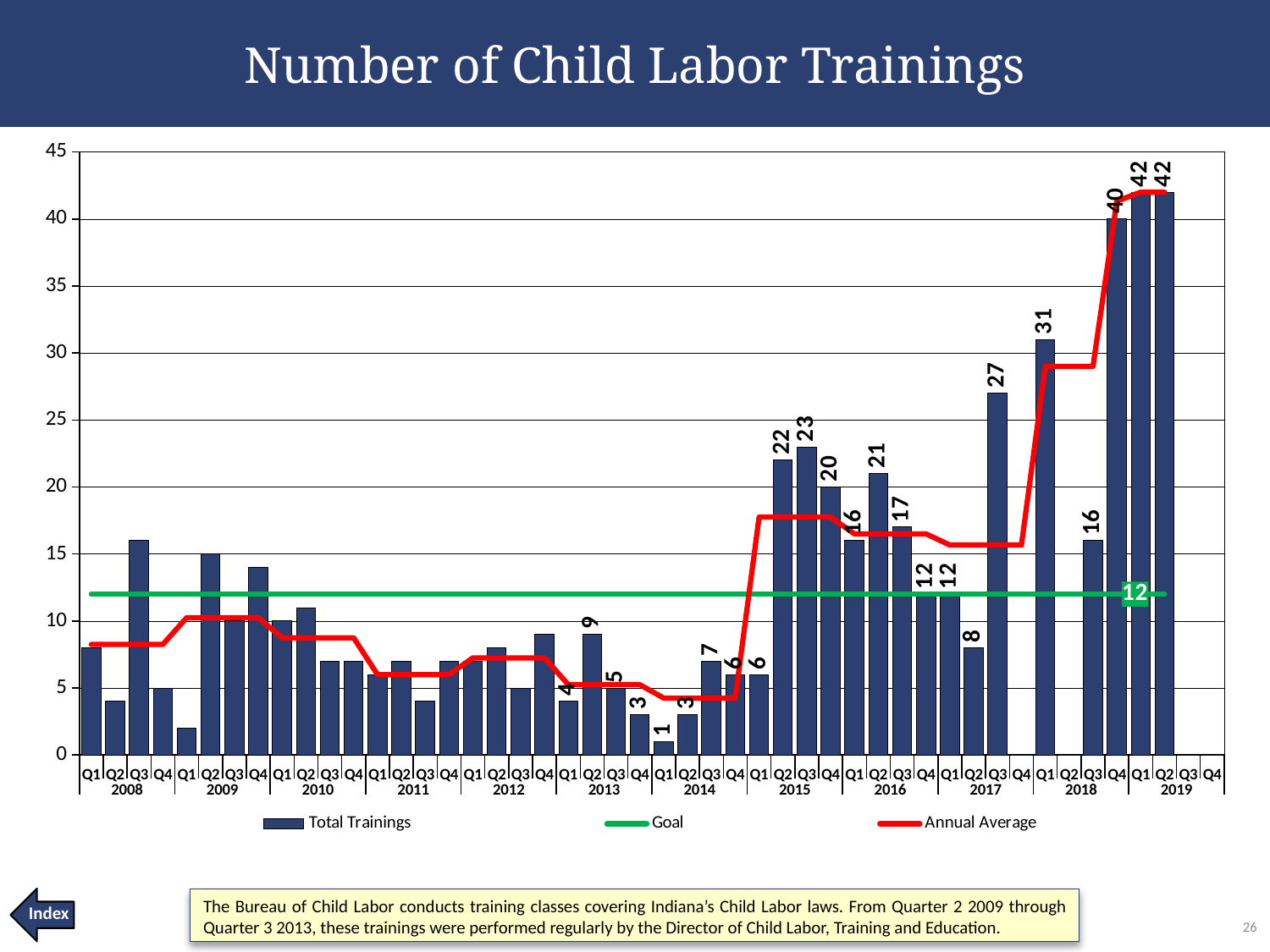
Is the value for Total Trainings in Q1 2009 greater or less than 5? less How many series does the legend list? 3 How many Total Trainings were there in Q3 2017? 27 What kind of chart is used to show the Total Trainings? bar chart What value is the Goal line set at? 12 How many Total Trainings were there in Q1 2018? 31 Which quarter had more Total Trainings, Q2 2016 or Q4 2015? Q2 2016 How many Total Trainings were there in Q4 2018? 40 Which quarter has the lowest number of Total Trainings? Q1 2014 How many Total Trainings were there in Q2 2017? 8 What is the difference in Total Trainings between Q1 2019 and Q4 2018? 2 What colour is the Goal line in the legend? green